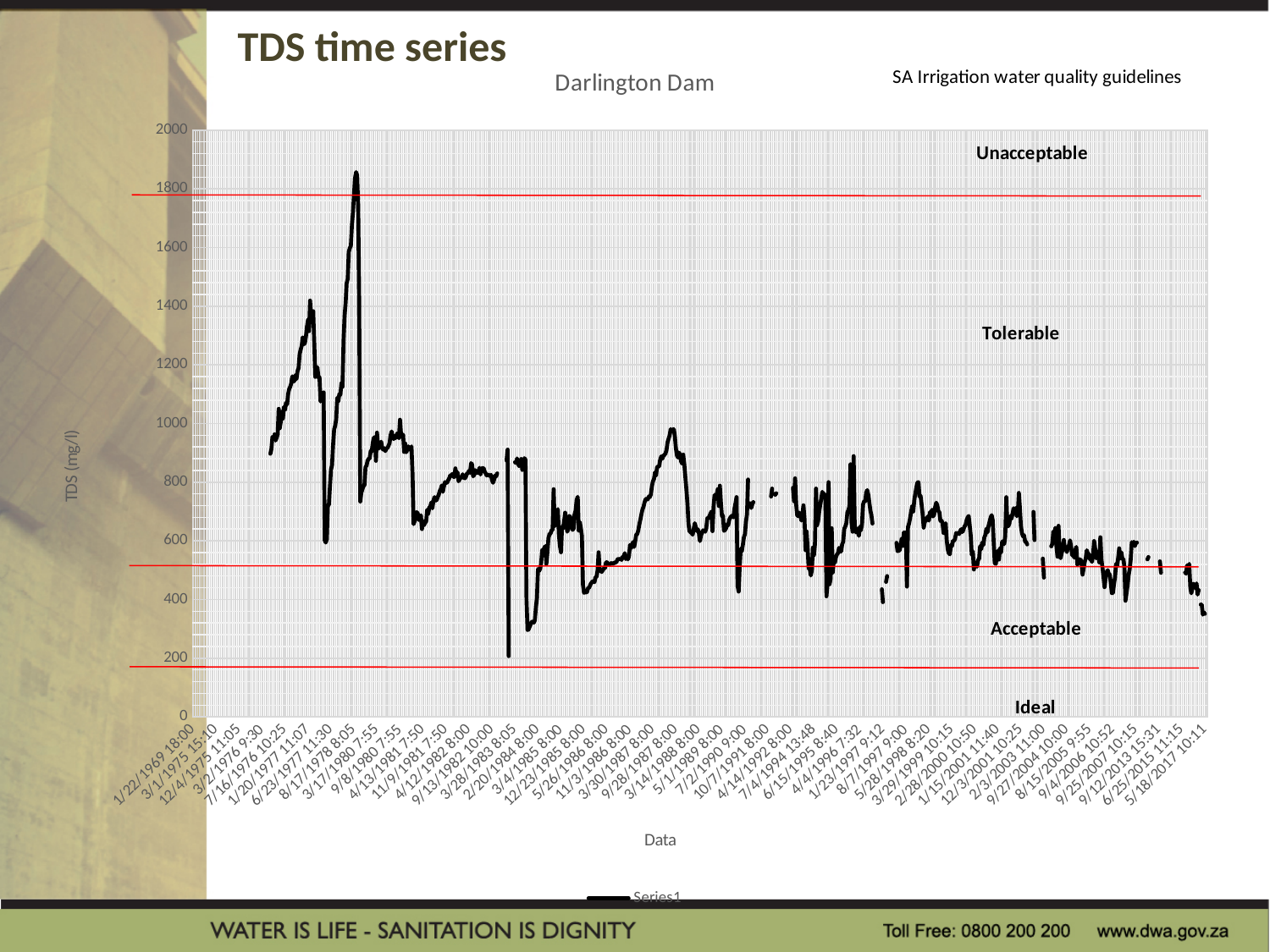
What is the label on the vertical axis of the chart? TDS (mg/l) Is the lowest TDS value plotted on the chart (around 1984) greater or less than 400? less What kind of chart is shown on the slide? line chart Overall, do the TDS values rise or fall from the start of the time series to the end? fall Is the last TDS value plotted on the chart (at 5/18/2017) greater or less than 600? less How many series does the chart legend list? 1 Is the TDS value at the peak around 1988 greater or less than 800? greater What is the title of the chart? Darlington Dam Which is larger: the TDS peak around 1978 or the TDS peak around 1988? the peak around 1978